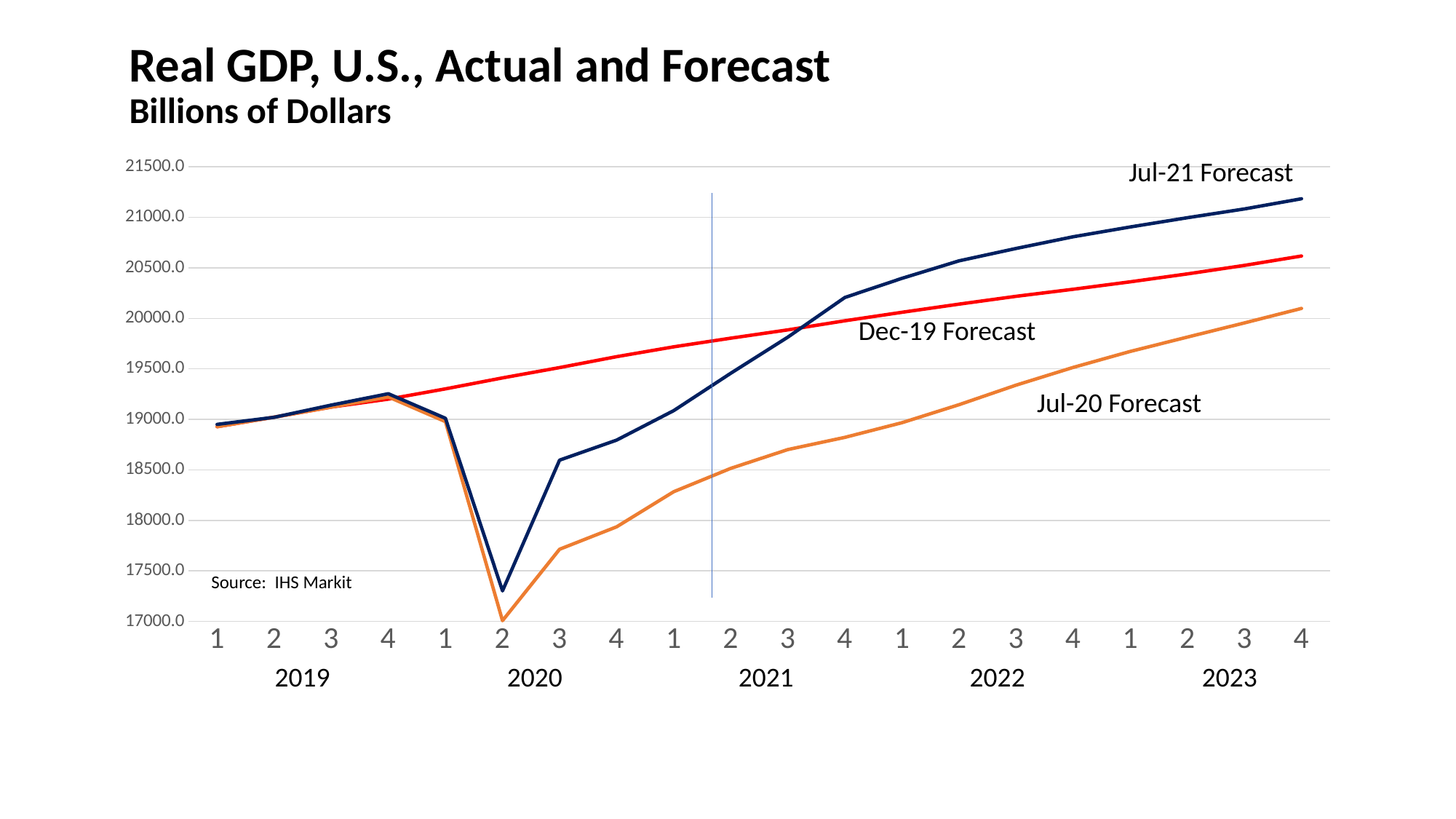
Is the value of the Dec-19 Forecast in quarter 4 of 2023 greater or less than 20500? greater Does the Dec-19 Forecast line rise or fall from 2019 to 2023? rise What kind of chart is shown on the slide? line chart Is the value of the Jul-21 Forecast in quarter 4 of 2023 greater or less than 21000? greater How many quarterly points are shown along the x axis? 20 How many forecast series are plotted on the chart? 3 In which quarter does the Jul-21 Forecast line reach its lowest point? Quarter 2 of 2020 What is the source cited on the chart? IHS Markit In quarter 4 of 2023, which is higher, the Jul-21 Forecast or the Dec-19 Forecast? Jul-21 Forecast Is the value of the Jul-21 Forecast in quarter 4 of 2021 greater or less than 20000? greater Which series has the lowest value in quarter 4 of 2023? Jul-20 Forecast